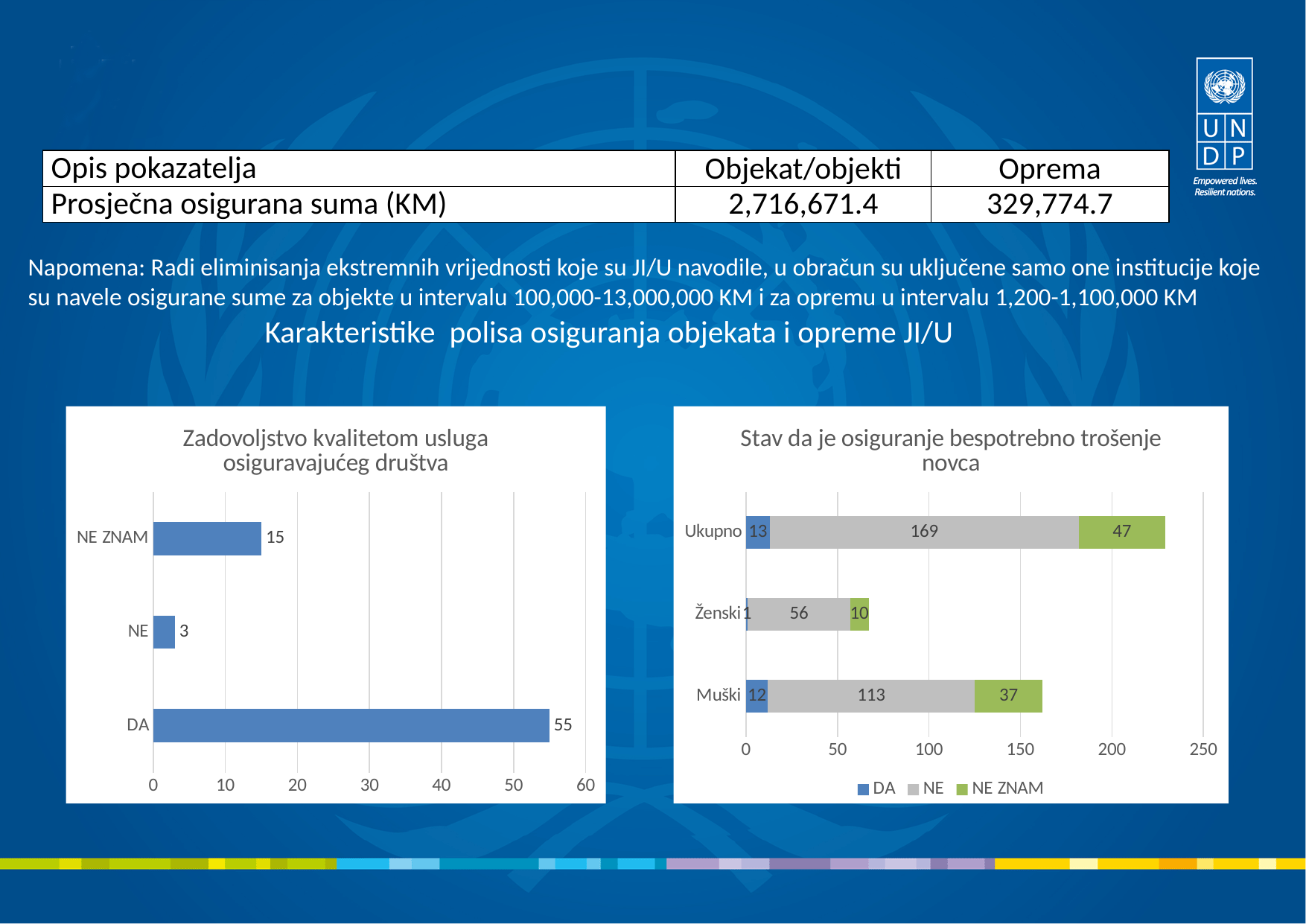
In the chart titled "Zadovoljstvo kvalitetom usluga osiguravajućeg društva", which category has the lowest value? NE In the chart titled "Zadovoljstvo kvalitetom usluga osiguravajućeg društva", how many categories are shown? 3 In the chart titled "Stav da je osiguranje bespotrebno trošenje novca", what is the total of the stacked bar for Ženski? 67 In the chart titled "Stav da je osiguranje bespotrebno trošenje novca", what colour represents the NE ZNAM series? Green In the chart titled "Stav da je osiguranje bespotrebno trošenje novca", what is the NE ZNAM value for Ukupno? 47 What kind of chart is the chart titled "Zadovoljstvo kvalitetom usluga osiguravajućeg društva"? Bar chart In the chart titled "Stav da je osiguranje bespotrebno trošenje novca", what is the NE value for Muški? 113 In the chart titled "Stav da je osiguranje bespotrebno trošenje novca", which is larger: the NE ZNAM value for Muški or the NE ZNAM value for Ženski? Muški In the chart titled "Stav da je osiguranje bespotrebno trošenje novca", what is the total of the stacked bar for Muški? 162 In the chart titled "Stav da je osiguranje bespotrebno trošenje novca", how many series does the legend list? 3 In the chart titled "Zadovoljstvo kvalitetom usluga osiguravajućeg društva", what is the difference between the values for DA and NE ZNAM? 40 In the chart titled "Zadovoljstvo kvalitetom usluga osiguravajućeg društva", what is the value for DA? 55